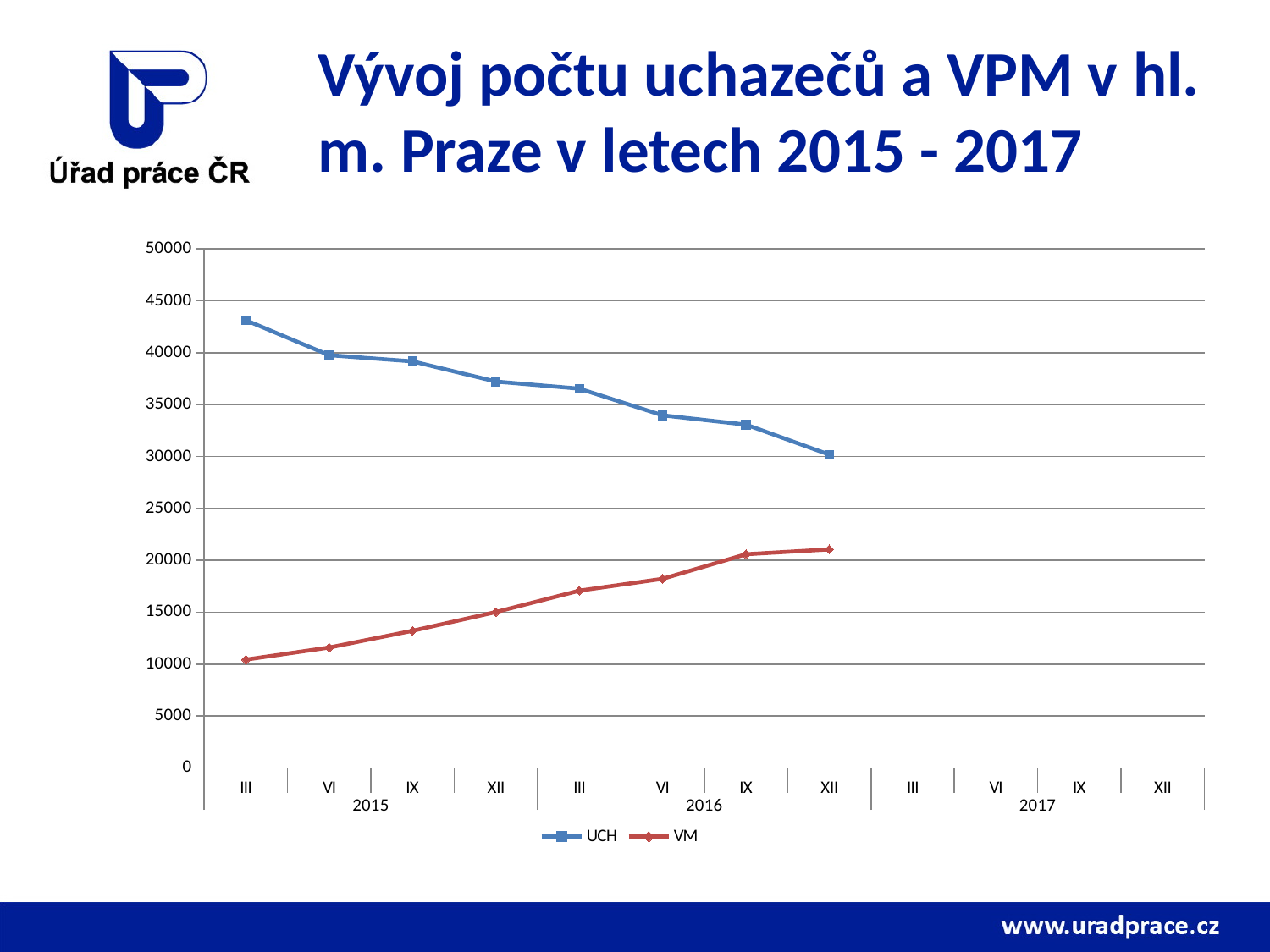
At which point is the VM series lowest? III 2015 Is the UCH value for XII 2016 greater or less than 35000? less What kind of chart is shown on the slide? line chart What are the two series named in the legend? UCH and VM Is the VM value for III 2016 greater or less than 15000? greater At XII 2016, which series has the larger value, UCH or VM? UCH Does the VM series rise or fall from III 2015 to XII 2016? rise At which point is the UCH series highest? III 2015 Is the VM value for III 2015 greater or less than 15000? less Does the UCH series rise or fall from III 2015 to XII 2016? fall How many series does the legend list? 2